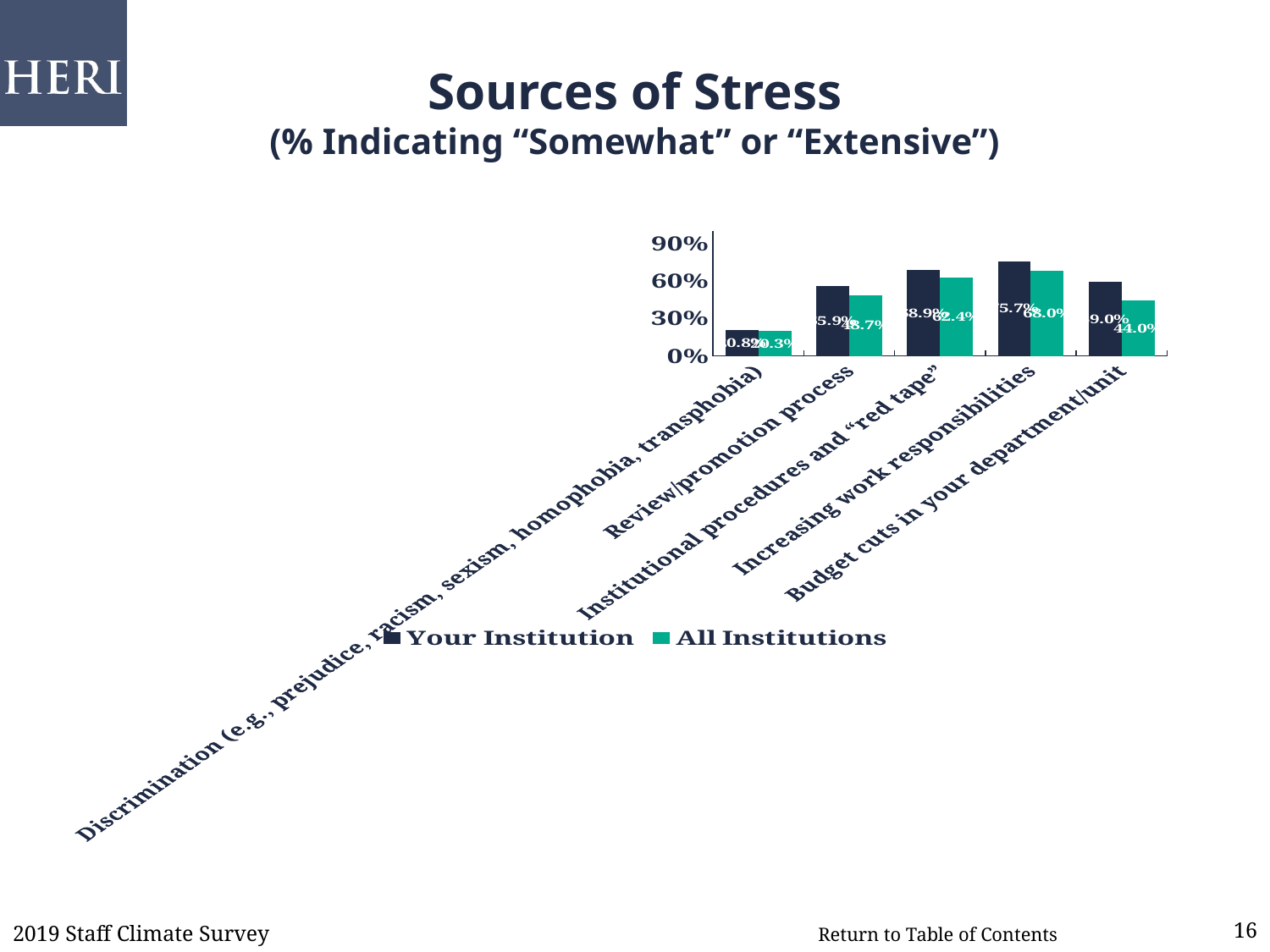
What are the two series named in the legend? Your Institution and All Institutions Is the Your Institution value for Increasing work responsibilities greater or less than 60%? greater For All Institutions, what is the difference between Increasing work responsibilities and Budget cuts in your department/unit? 24.0% How many sources of stress (categories) are plotted on the x axis? 5 Which category has the lowest All Institutions value? Discrimination (e.g., prejudice, racism, sexism, homophobia, transphobia) How many series does the legend list? 2 What is the All Institutions value for Review/promotion process? 48.7% For Budget cuts in your department/unit, which is larger: Your Institution or All Institutions? Your Institution What is the All Institutions value for Increasing work responsibilities? 68.0% What kind of chart is shown on the slide? bar chart What is the All Institutions value for Budget cuts in your department/unit? 44.0% Which category has the highest All Institutions value? Increasing work responsibilities